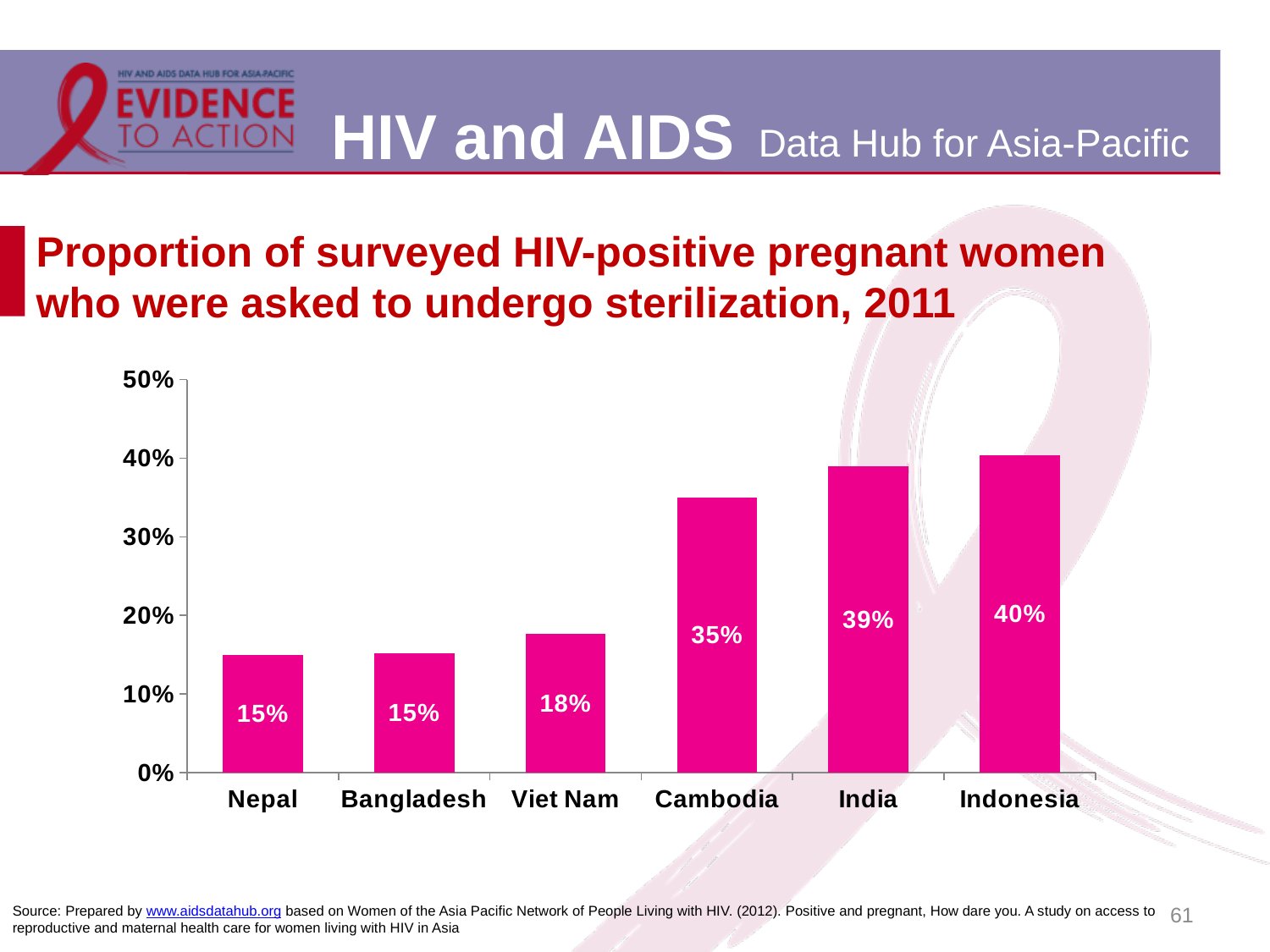
What is the value for India? 39% Is the value for India greater or less than 30%? greater What is the value for Viet Nam? 18% How many countries are shown on the chart? 6 Which is larger, the value for Cambodia or the value for Bangladesh? Cambodia What kind of chart is shown on the slide? bar chart What is the difference between the values for Indonesia and Nepal? 25% What is the difference between the values for Cambodia and Viet Nam? 17% Do the values generally rise or fall from Nepal to Indonesia along the x axis? rise Which country has the highest value? Indonesia What year is given in the chart title? 2011 What is the value for Cambodia? 35%